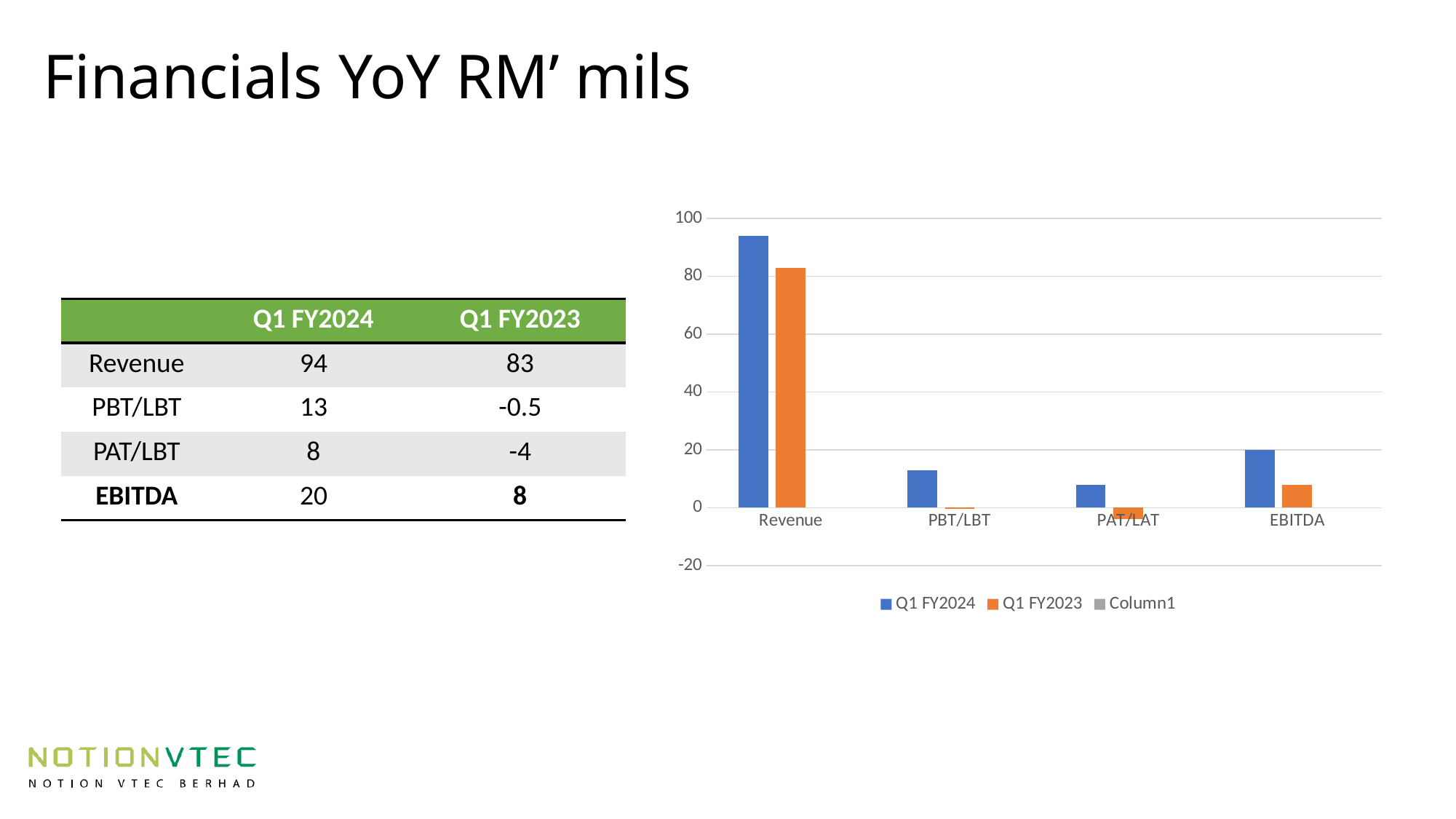
What is the Q1 FY2024 value for Revenue? 94 How many series does the chart legend list? 3 What is the difference between the Q1 FY2024 and Q1 FY2023 values for Revenue? 11 What kind of chart is shown on the slide? bar chart Which colour represents the Q1 FY2023 series in the chart? orange Which category has the lowest Q1 FY2023 value? PAT/LAT How many categories are shown on the x axis of the chart? 4 Which is larger for EBITDA, the Q1 FY2024 value or the Q1 FY2023 value? Q1 FY2024 What is the Q1 FY2024 value for EBITDA? 20 What is the Q1 FY2023 value for Revenue? 83 Which category has the highest Q1 FY2024 value? Revenue Is the Q1 FY2024 value for Revenue greater or less than 80? greater